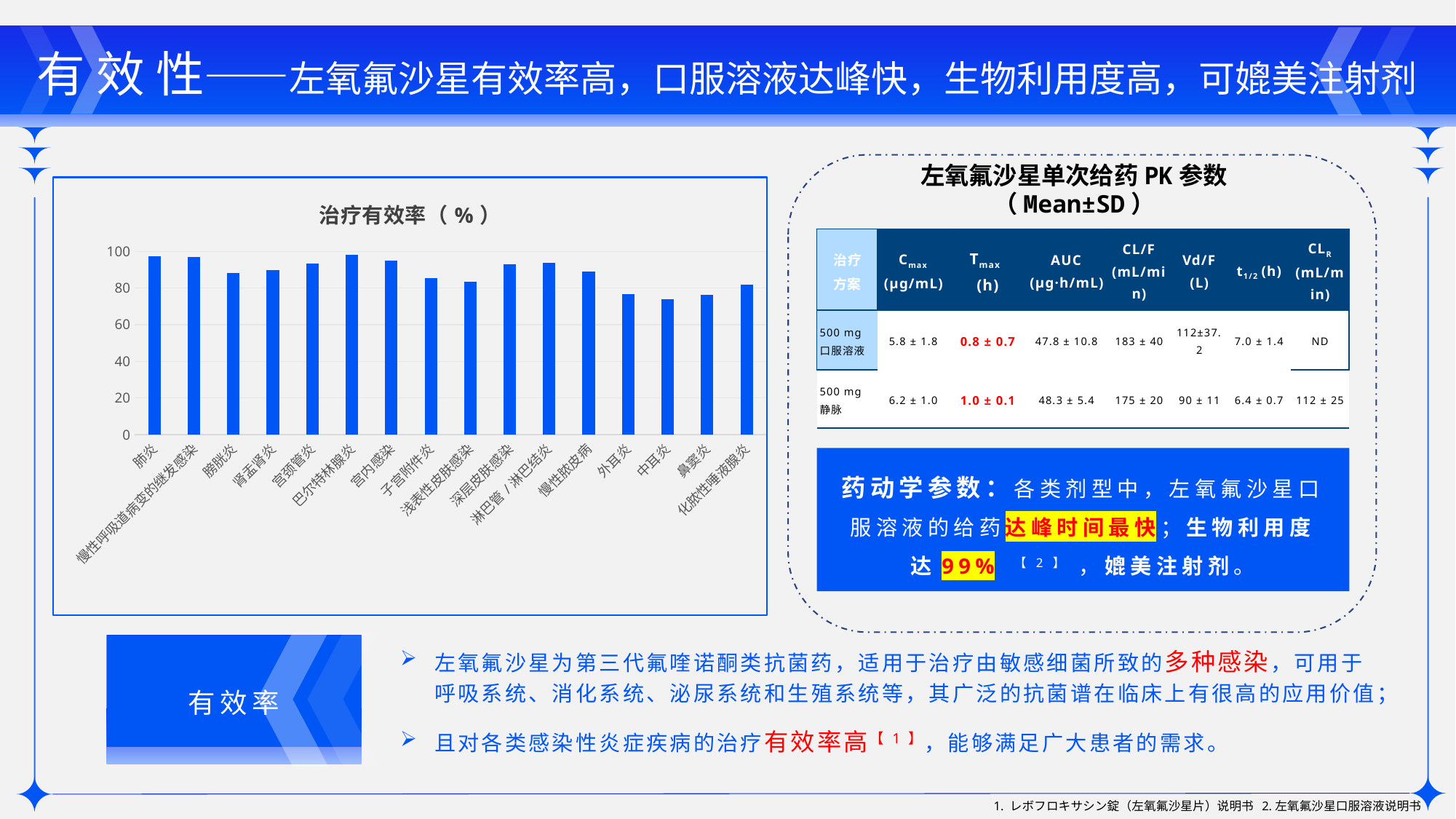
What kind of chart is shown on the left of the slide? bar chart What is the title of the bar chart on the left? 治疗有效率（%） In the 治疗有效率（%） chart, which has the larger value, 巴尔特林腺炎 or 鼻窦炎? 巴尔特林腺炎 How many categories are plotted in the 治疗有效率（%） bar chart? 16 In the 治疗有效率（%） chart, which has the larger value, 宫内感染 or 外耳炎? 宫内感染 In the 治疗有效率（%） chart, is the value for 宫内感染 greater or less than 80? greater What is the highest value shown on the y axis of the 治疗有效率（%） chart? 100 In the 治疗有效率（%） chart, is the value for 外耳炎 greater or less than 80? less In the 治疗有效率（%） chart, which has the larger value, 肺炎 or 中耳炎? 肺炎 In the 治疗有效率（%） chart, is the value for 中耳炎 greater or less than 80? less